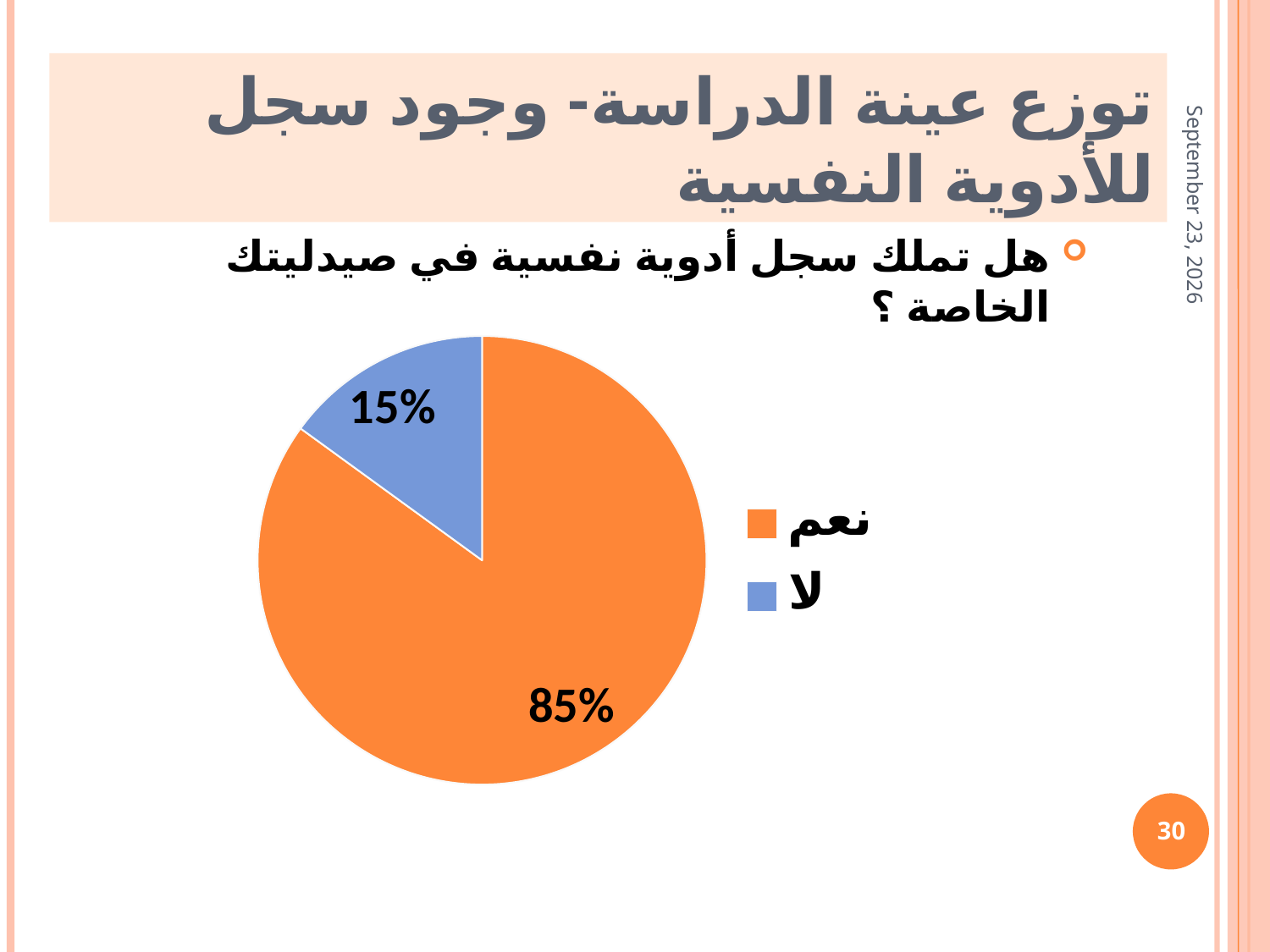
What share of the pie does the "نعم" (yes) slice represent? 85% What share of the pie does the "لا" (no) slice represent? 15% How many categories does the pie chart have? 2 How many entries does the legend list? 2 What kind of chart is shown on the slide? Pie chart What is the difference in percentage points between the "نعم" and "لا" slices? 70 Which category has the smallest slice of the pie? لا Which category has the largest slice of the pie? نعم Which is larger, the "نعم" slice or the "لا" slice? نعم What colour is the "نعم" slice in the pie chart? Orange What colour is the "لا" slice in the pie chart? Blue